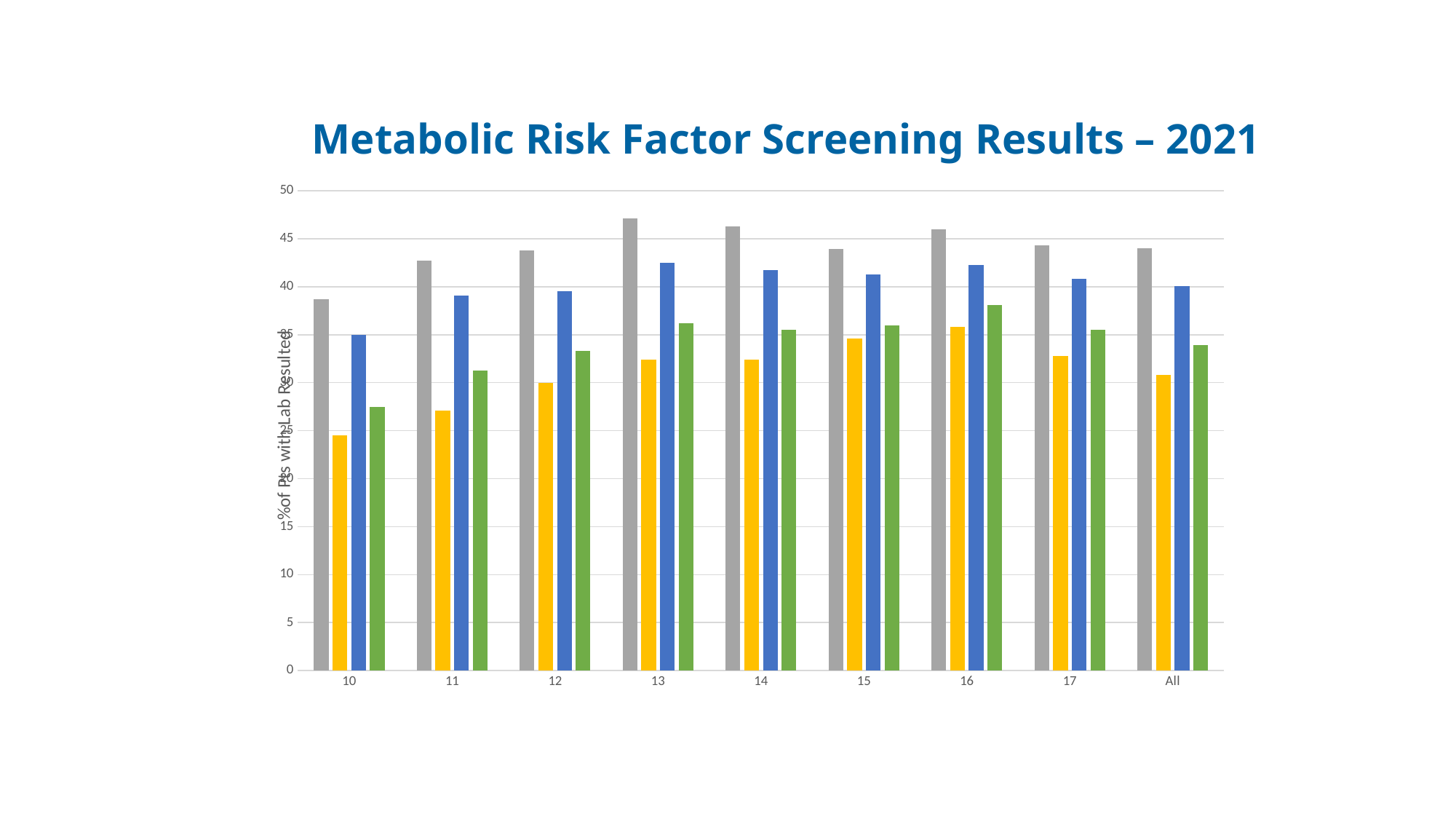
What is the title of the chart? Metabolic Risk Factor Screening Results – 2021 Among the yellow bars, which category has the lowest value? 10 What kind of chart is shown on the slide? bar chart For category 10, which is larger: the grey bar or the blue bar? the grey bar Is the value of the grey bar for category 10 greater or less than 40? less How many bars are plotted for each category on the x axis? 4 Is the value of the blue bar for category 13 greater or less than 40? greater Among the green bars, which category has the highest value? 16 Is the value of the green bar for category 10 greater or less than 25? greater How many categories are shown along the x axis? 9